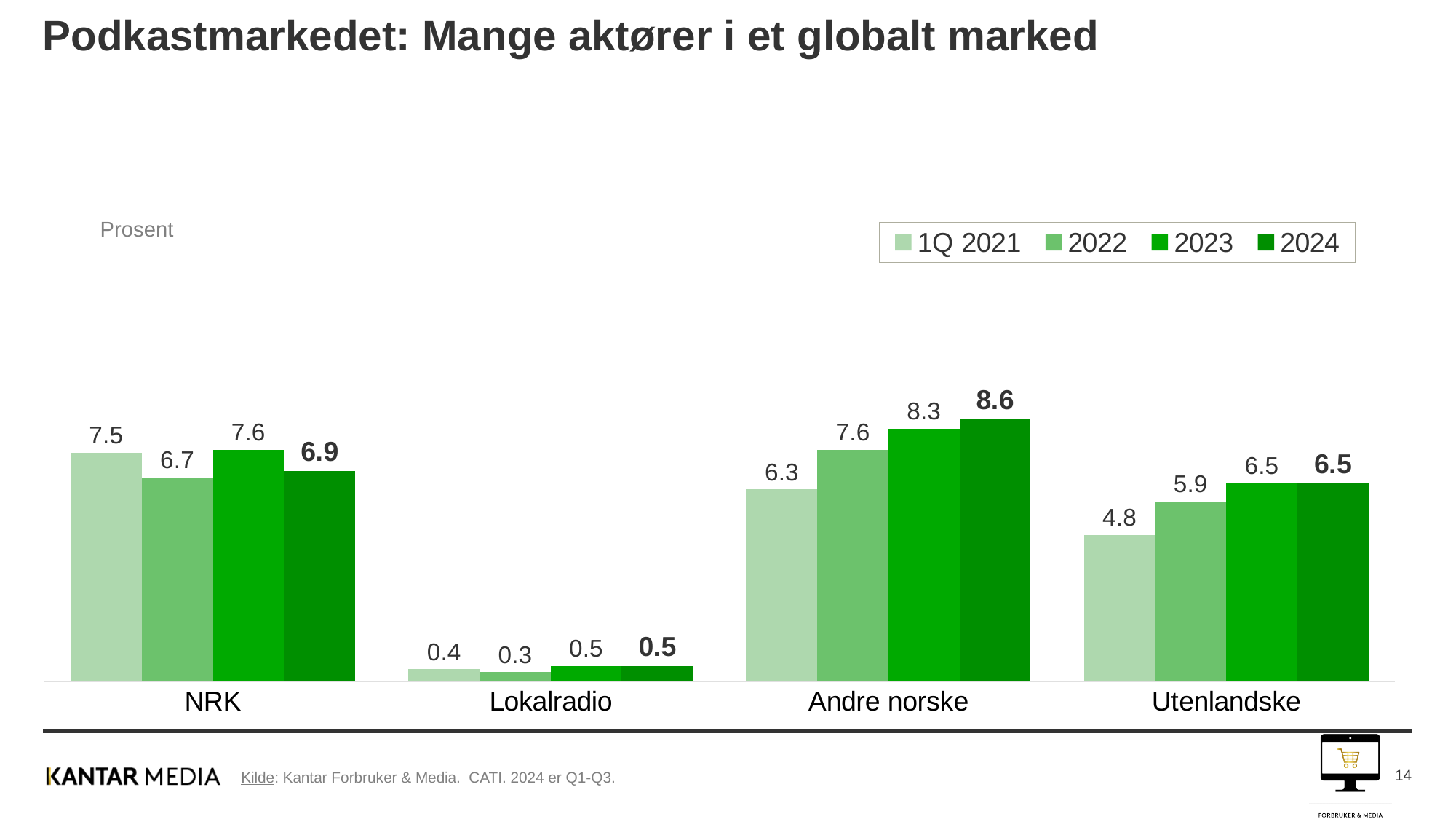
What is the difference between the 2024 and 1Q 2021 values for Utenlandske? 1.7 What is the value for Andre norske in 1Q 2021? 6.3 Which is larger for NRK: the 2022 value or the 2023 value? 2023 Which category has the highest value in 2024? Andre norske What is the value for NRK in 2024? 6.9 What kind of chart is shown on the slide? Bar chart How many series does the legend list? 4 How many categories are shown on the x axis? 4 What is the value for Utenlandske in 2022? 5.9 Do the values for Andre norske rise or fall from 1Q 2021 to 2024? Rise What unit label is shown above the chart? Prosent Which category has the lowest value in 2023? Lokalradio